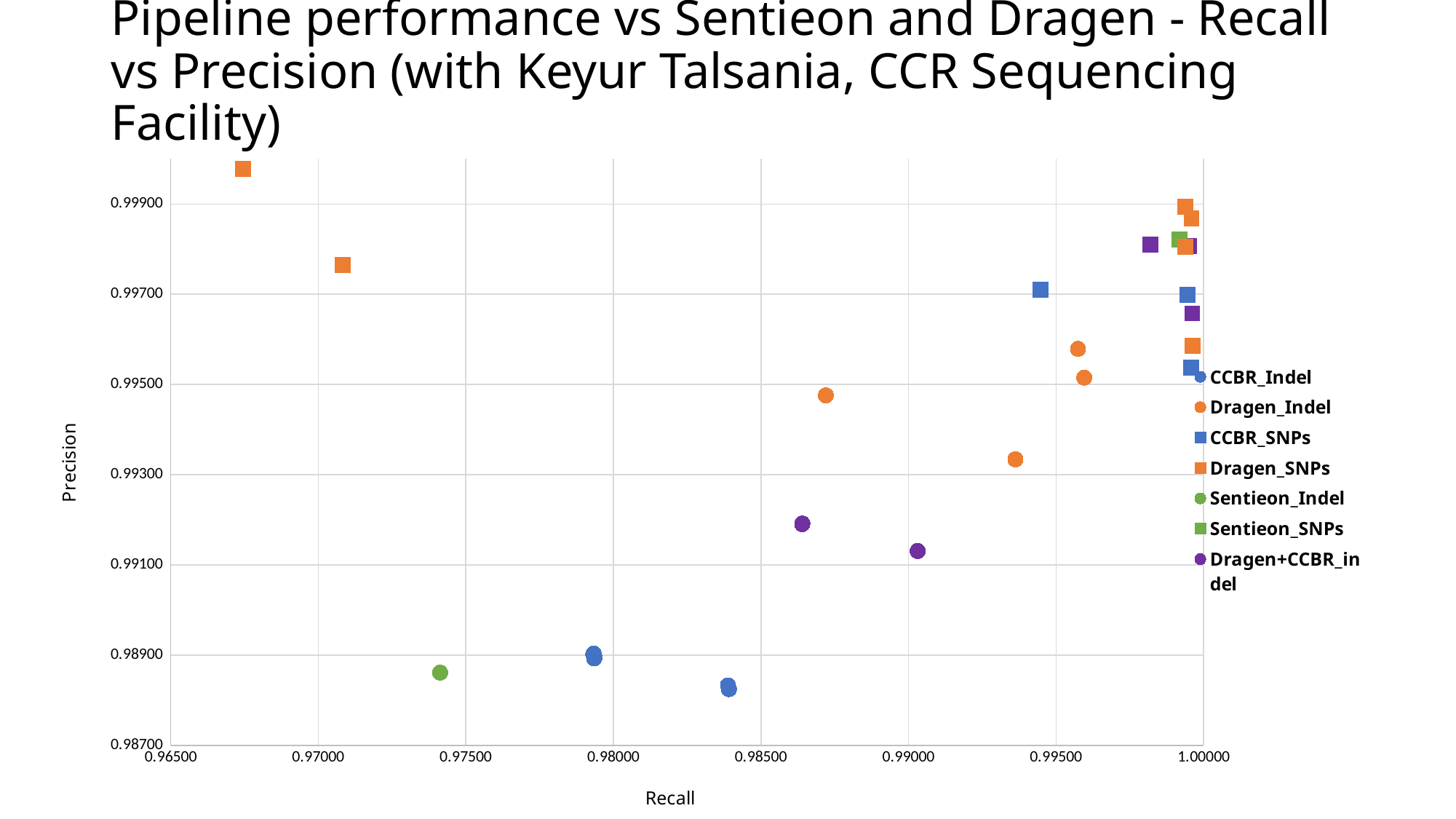
Which series has the point with the highest precision on the chart? Dragen_SNPs Is the recall of the leftmost Dragen_SNPs point greater or less than 0.97000? less How many series does the legend list? 7 Is the precision of the leftmost Dragen_SNPs point greater or less than 0.99900? greater Are the precision values of the CCBR_Indel points greater or less than 0.99100? less What is the title of the y axis? Precision Which series has the point with the lowest recall on the chart? Dragen_SNPs What is the title of the x axis? Recall What kind of chart is shown on the slide? Scatter chart